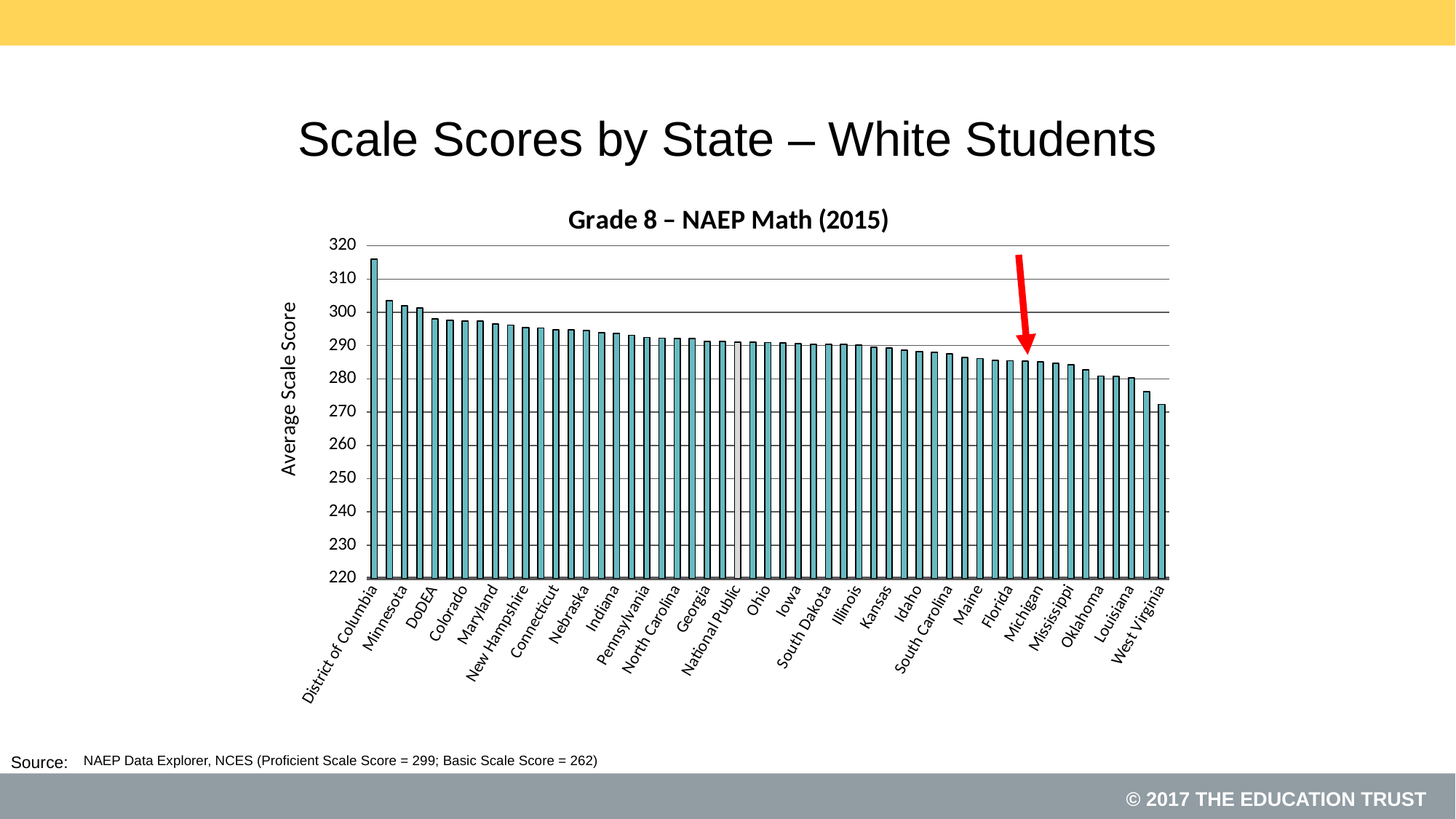
Which state has the lowest average scale score in the chart? West Virginia Which has a higher average scale score, Minnesota or Michigan? Minnesota What kind of chart is shown on the slide? bar chart Do the values rise or fall moving from left to right along the x axis? fall Is the value for Mississippi greater or less than 280? greater Is the value for Colorado greater or less than 300? less Is the value for West Virginia greater or less than 280? less What is the label on the vertical axis of the chart? Average Scale Score What is the title of the chart? Grade 8 – NAEP Math (2015) Which state has the highest average scale score in the chart? District of Columbia